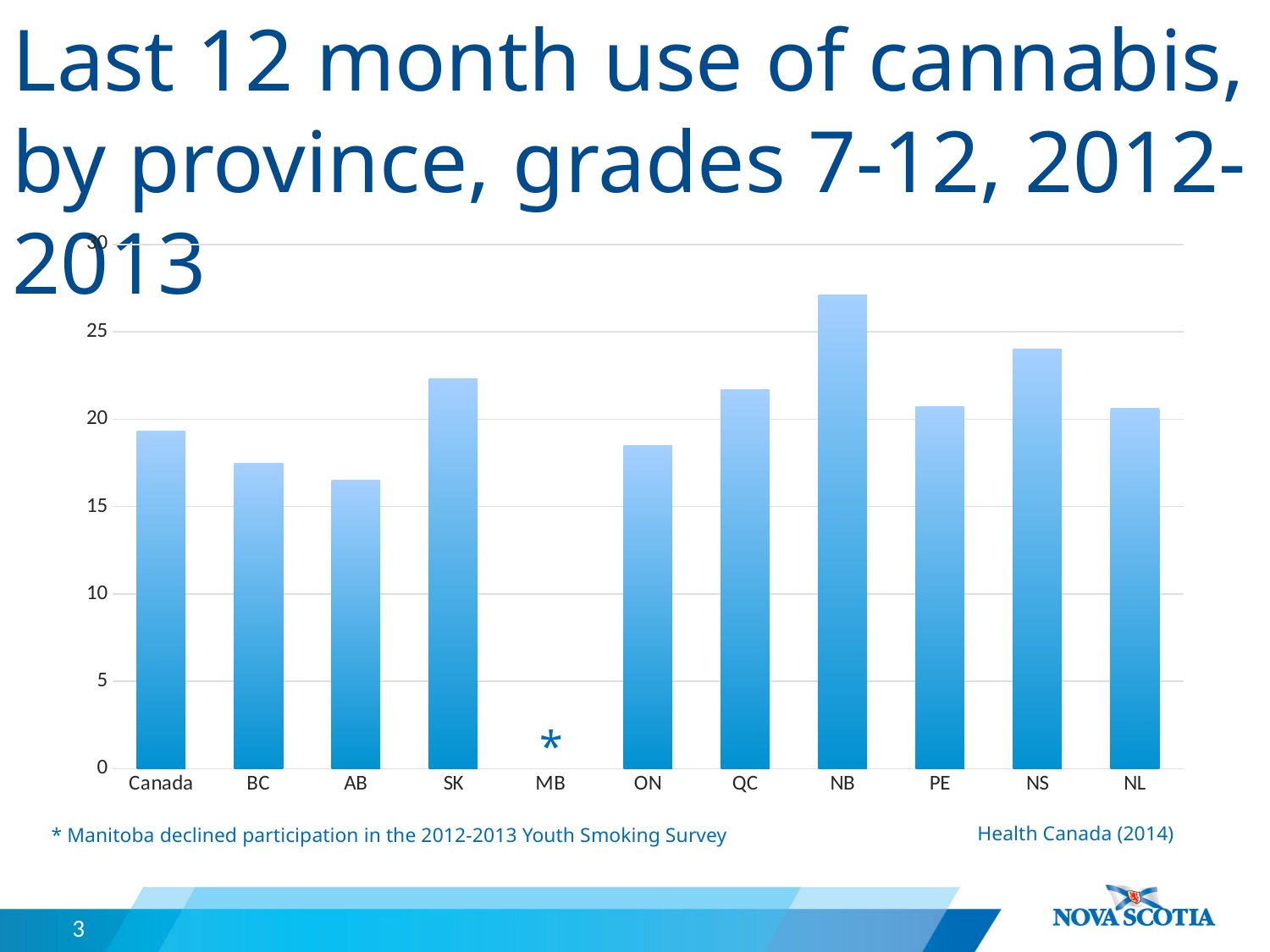
Is the value for NS greater or less than 25? less Which province has no bar plotted and is marked with an asterisk instead? MB Among the categories with a plotted bar, which has the lowest value? AB Is the value for Canada greater or less than 20? less Is the value for NB greater or less than 25? greater Which has the larger value, NB or NS? NB How many categories are shown along the x axis of the chart? 11 Which has the larger value, SK or ON? SK What kind of chart is shown on the slide? Bar chart Which category has the highest bar in the chart? NB